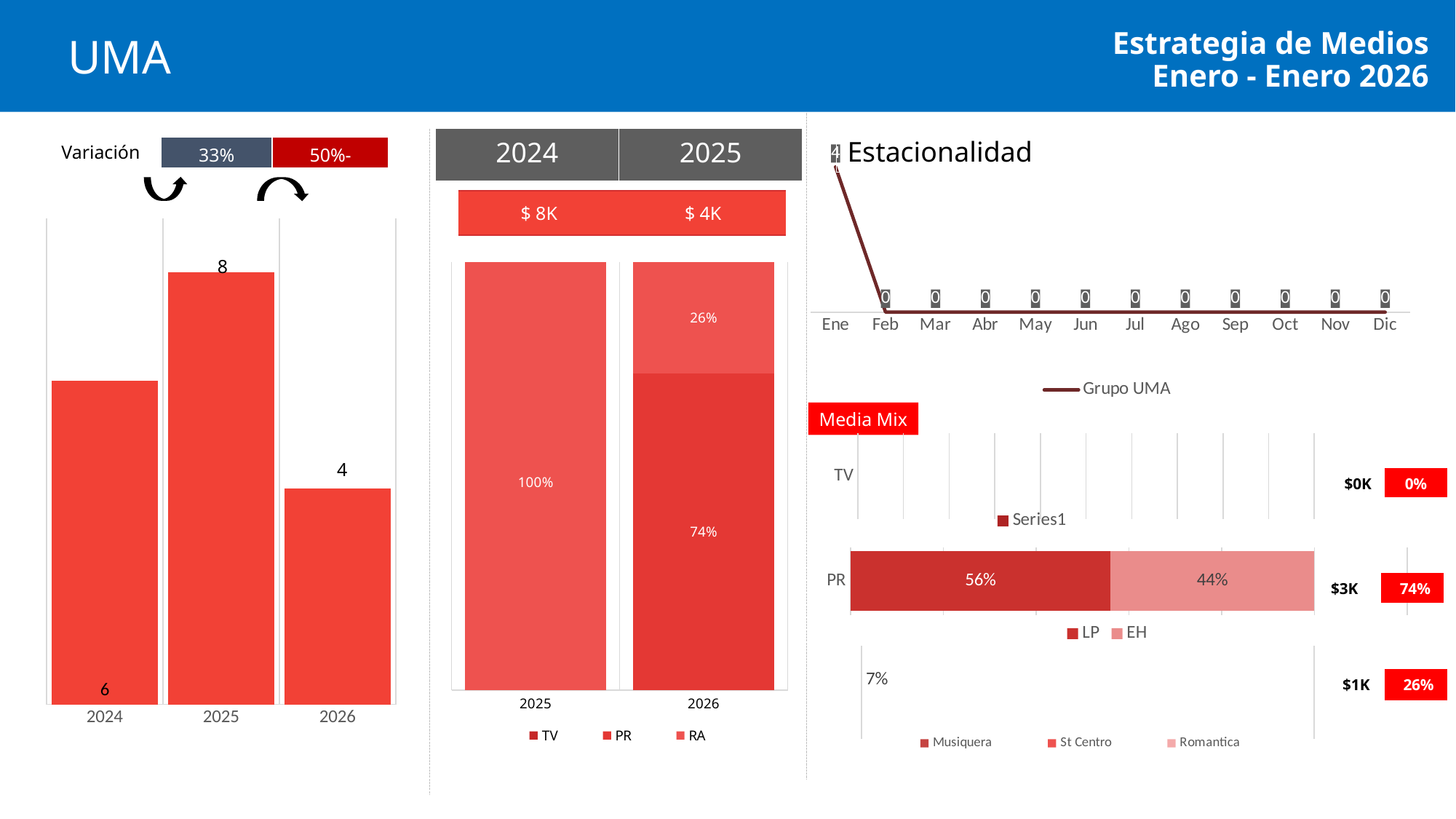
In the stacked bar chart in the middle, what percentage does the top segment of the 2026 bar show? 26% In the bar chart on the left, what is the difference between the values for 2025 and 2026? 4 In the bar chart on the left, how many years are shown? 3 In the stacked bar chart in the middle, what percentage does the 2025 bar show? 100% In the Media Mix PR bar, what percentage is shown for LP? 56% In the Estacionalidad line chart, what is the value for Ene? 4 In the Estacionalidad line chart, how many months are plotted on the x axis? 12 In the bar chart on the left, what is the value for 2026? 4 In the bar chart on the left, what is the value for 2025? 8 In the bar chart on the left, which year has the lowest value? 2026 In the bar chart on the left, which year has the highest value? 2025 In the stacked bar chart in the middle, how many series does the legend list? 3